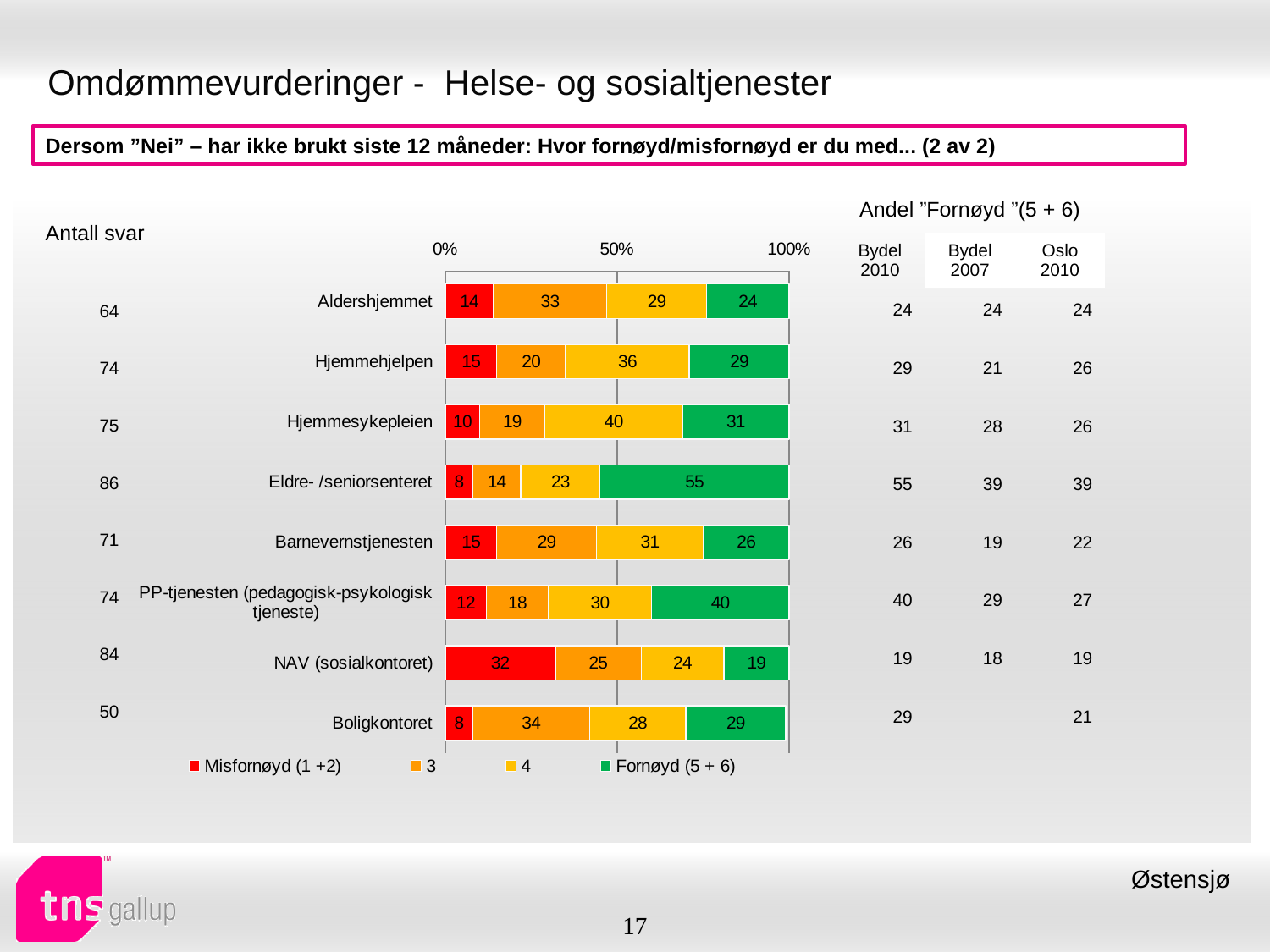
What is the total of the stacked bar for Aldershjemmet? 100 Which has a larger Fornøyd (5 + 6) value, Hjemmesykepleien or Hjemmehjelpen? Hjemmesykepleien What is the value of the Misfornøyd (1 +2) segment for NAV (sosialkontoret)? 32 What is the difference between the Fornøyd (5 + 6) values for Eldre- /seniorsenteret and Aldershjemmet? 31 How many categories are shown in the chart? 8 What is the value of the Fornøyd (5 + 6) segment for Eldre- /seniorsenteret? 55 How many series does the legend list? 4 Which category has the highest Misfornøyd (1 +2) value? NAV (sosialkontoret) Which category has the lowest Fornøyd (5 + 6) value? NAV (sosialkontoret) What is the value of the '4' segment for Hjemmesykepleien? 40 What kind of chart is shown on the slide? Stacked bar chart Which category has the highest Fornøyd (5 + 6) value? Eldre- /seniorsenteret